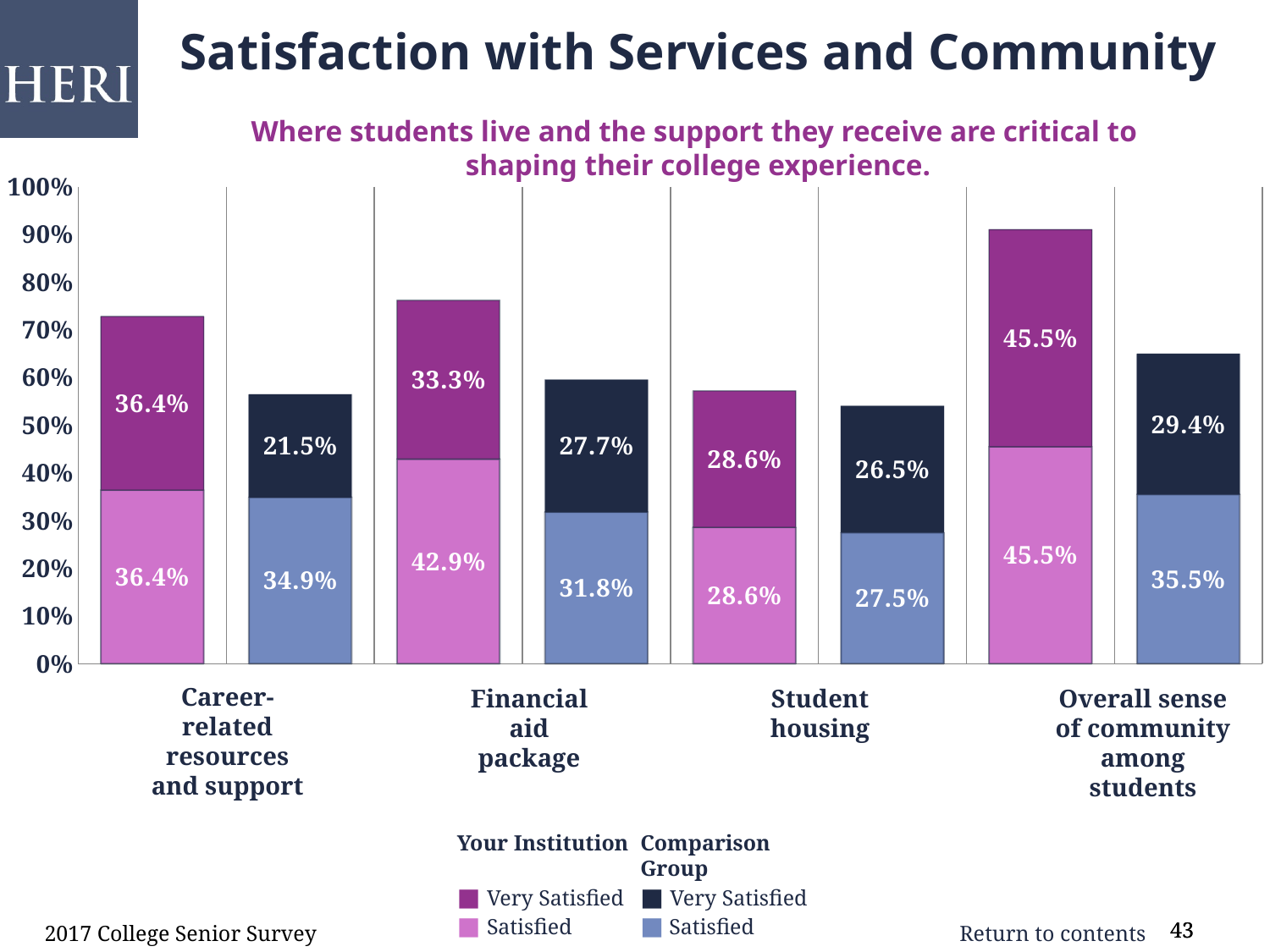
How many categories are shown on the x axis of the chart? 4 What is the difference between the Your Institution and Comparison Group Very Satisfied percentages for overall sense of community among students? 16.1% How many series does the legend list? 4 What percentage of the Comparison Group was Satisfied with student housing? 27.5% What kind of chart is shown on the slide? Stacked bar chart Which category has the highest Very Satisfied percentage for Your Institution? Overall sense of community among students What is the total of the stacked Your Institution bar for overall sense of community among students? 91.0% Which is larger: the Your Institution Satisfied percentage for the financial aid package or the Comparison Group Satisfied percentage for the financial aid package? Your Institution (42.9%) Which category has the lowest Very Satisfied percentage for the Comparison Group? Career-related resources and support What percentage of the Comparison Group was Very Satisfied with career-related resources and support? 21.5% What percentage of Your Institution students were Very Satisfied with the financial aid package? 33.3% What is the total of the stacked Comparison Group bar for career-related resources and support? 56.4%